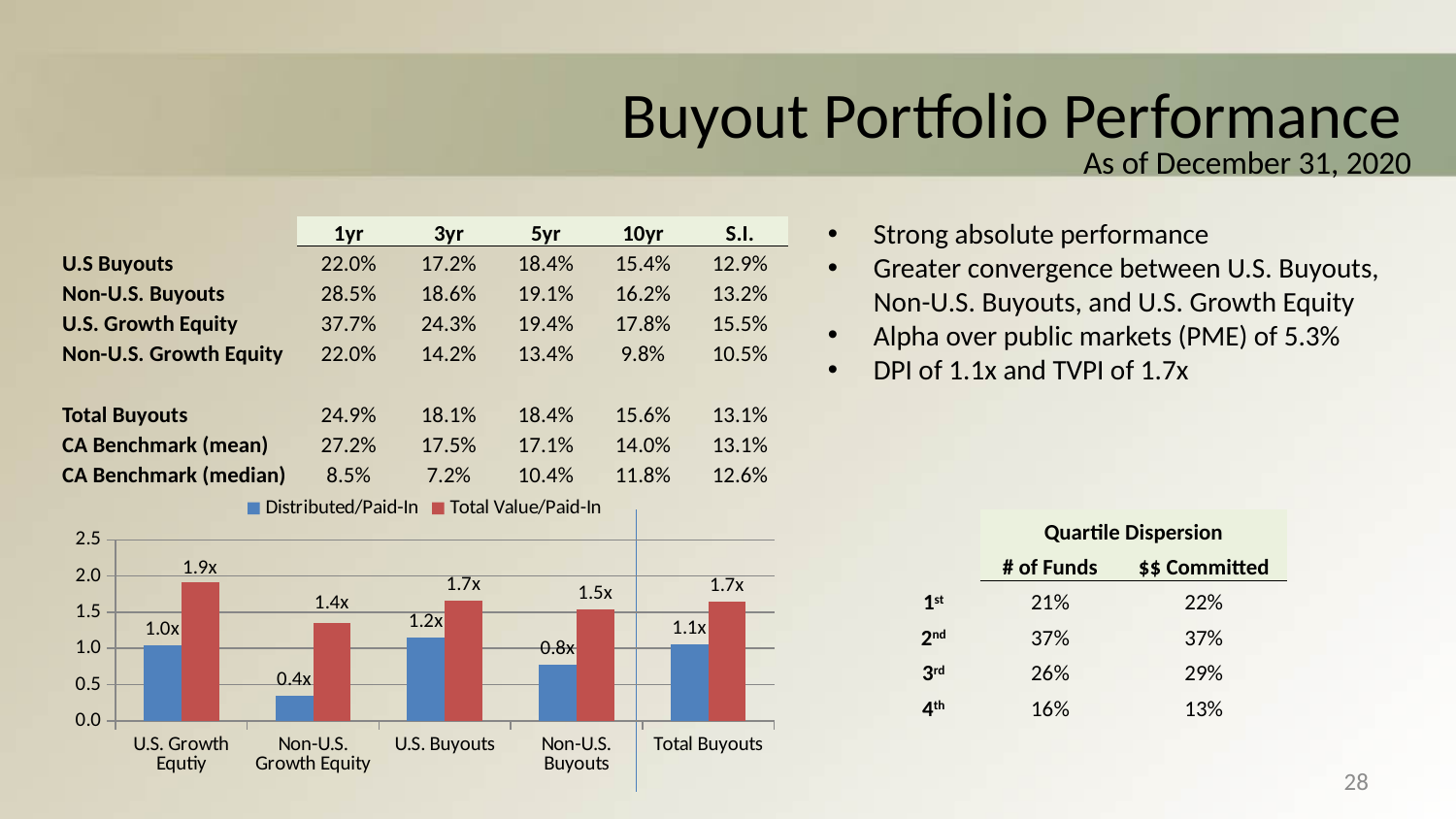
How many categories are shown on the x axis of the chart? 5 Which is larger, the Distributed/Paid-In value for U.S. Buyouts or for Non-U.S. Buyouts? U.S. Buyouts What is the Distributed/Paid-In value for U.S. Buyouts? 1.2x What kind of chart is shown on the slide? bar chart Which colour represents the Total Value/Paid-In series in the chart? red Which category has the lowest Distributed/Paid-In value? Non-U.S. Growth Equity What is the Total Value/Paid-In value for Total Buyouts? 1.7x What is the Total Value/Paid-In value for Non-U.S. Growth Equity? 1.4x Which category has the highest Total Value/Paid-In value? U.S. Growth Equity What is the difference between the Total Value/Paid-In and Distributed/Paid-In values for Non-U.S. Growth Equity? 1.0x How many series does the chart legend list? 2 Is the Total Value/Paid-In value for U.S. Growth Equity greater or less than 1.5? greater